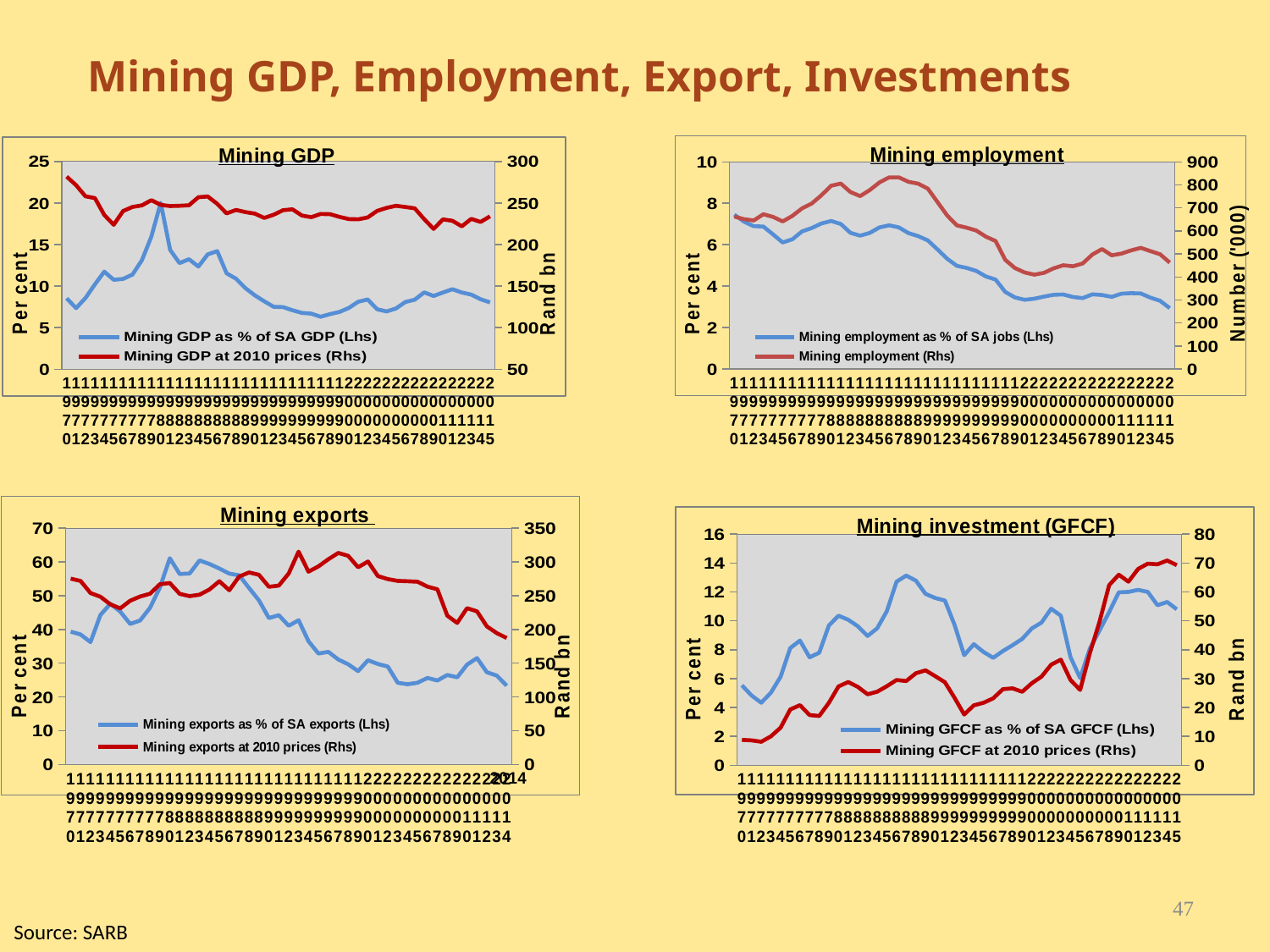
How many charts are shown on the slide? 4 What colour is the Mining exports at 2010 prices (Rhs) line in the Mining exports chart? red How many series does the legend of the Mining employment chart list? 2 In the Mining employment chart, is the value of Mining employment as % of SA jobs in 2015 greater or less than 4? less In the Mining investment (GFCF) chart, does the Mining GFCF at 2010 prices line rise or fall overall from 1970 to 2015? rise What kind of chart is the Mining GDP chart? line chart In the Mining investment (GFCF) chart, is the value of Mining GFCF at 2010 prices in 2015 greater or less than 60? greater What is the label of the right-hand axis of the Mining employment chart? Number ('000) In the Mining employment chart, does the Mining employment as % of SA jobs line rise or fall overall from 1970 to 2015? fall In the Mining GDP chart, is the value of Mining GDP as % of SA GDP in 1970 greater or less than 10? less